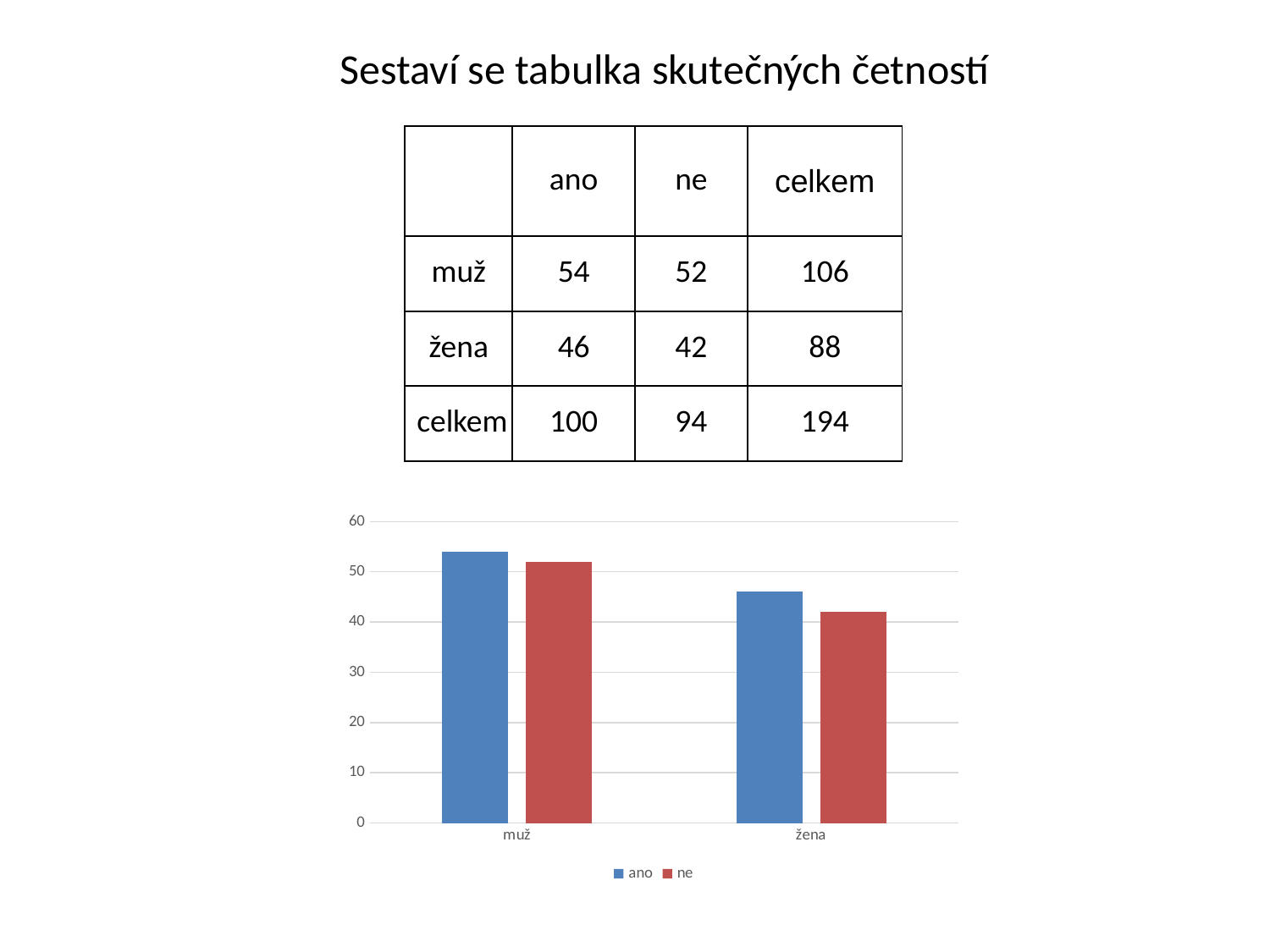
What is the value of the 'ne' bar for 'žena'? 42 Which category has the higher 'ano' bar, 'muž' or 'žena'? muž What is the value of the 'ano' bar for 'muž'? 54 How many series does the chart legend list? 2 Is the 'ne' value for 'žena' greater or less than 50? less For 'žena', which bar is larger, 'ano' or 'ne'? ano What is the difference between the 'ano' value for 'muž' and the 'ano' value for 'žena'? 8 What kind of chart is shown on the slide? bar chart Do the 'ano' values rise or fall from 'muž' to 'žena'? fall What are the two entries in the chart legend? ano, ne Is the 'ano' value for 'muž' greater or less than 50? greater How many categories are shown on the x axis of the chart? 2